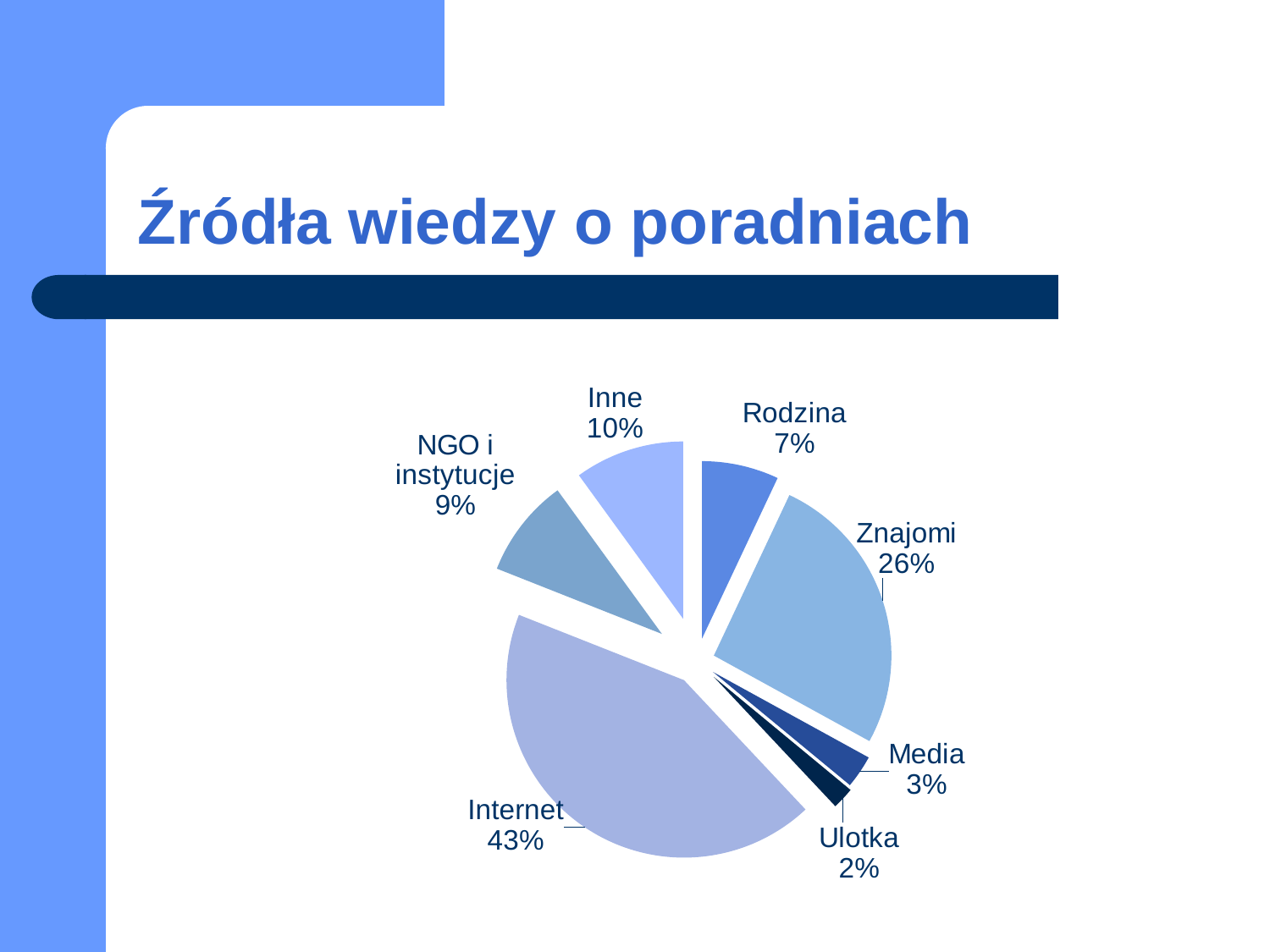
What share of the pie does Internet account for? 43% Which is larger, Inne or Rodzina? Inne What is the combined share of Media and Ulotka? 5% What is the title of the slide containing the chart? Źródła wiedzy o poradniach Which category has the smallest slice of the pie? Ulotka What is the value shown for Znajomi? 26% Which category has the largest slice of the pie? Internet How many categories are shown in the pie chart? 7 What kind of chart is shown on the slide? Pie chart What is the value for Ulotka? 2% What percentage is shown for NGO i instytucje? 9% What is the difference between the Internet and Znajomi shares? 17%